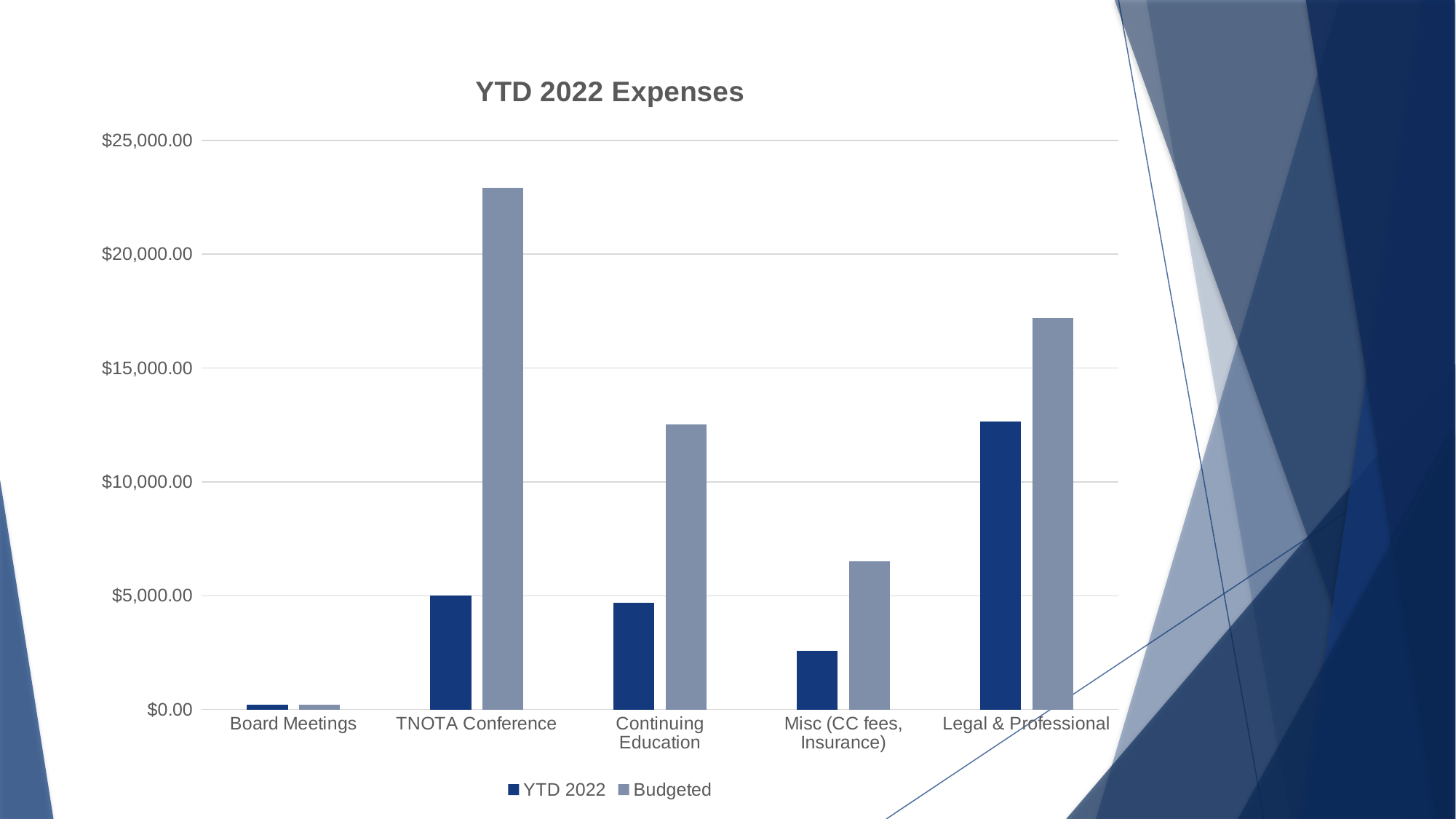
What kind of chart is shown on the slide? bar chart Which category has the highest YTD 2022 value? Legal & Professional For Continuing Education, which is larger: the YTD 2022 value or the Budgeted value? Budgeted How many expense categories are shown on the x axis? 5 How many series does the legend list? 2 Is the Budgeted value for TNOTA Conference greater or less than $20,000.00? greater What is the title of the chart? YTD 2022 Expenses Which category has the highest Budgeted value? TNOTA Conference Is the Budgeted value for Misc (CC fees, Insurance) greater or less than $5,000.00? greater Is the YTD 2022 value for Legal & Professional greater or less than $10,000.00? greater Which category has the lowest Budgeted value? Board Meetings What are the two series named in the legend? YTD 2022 and Budgeted